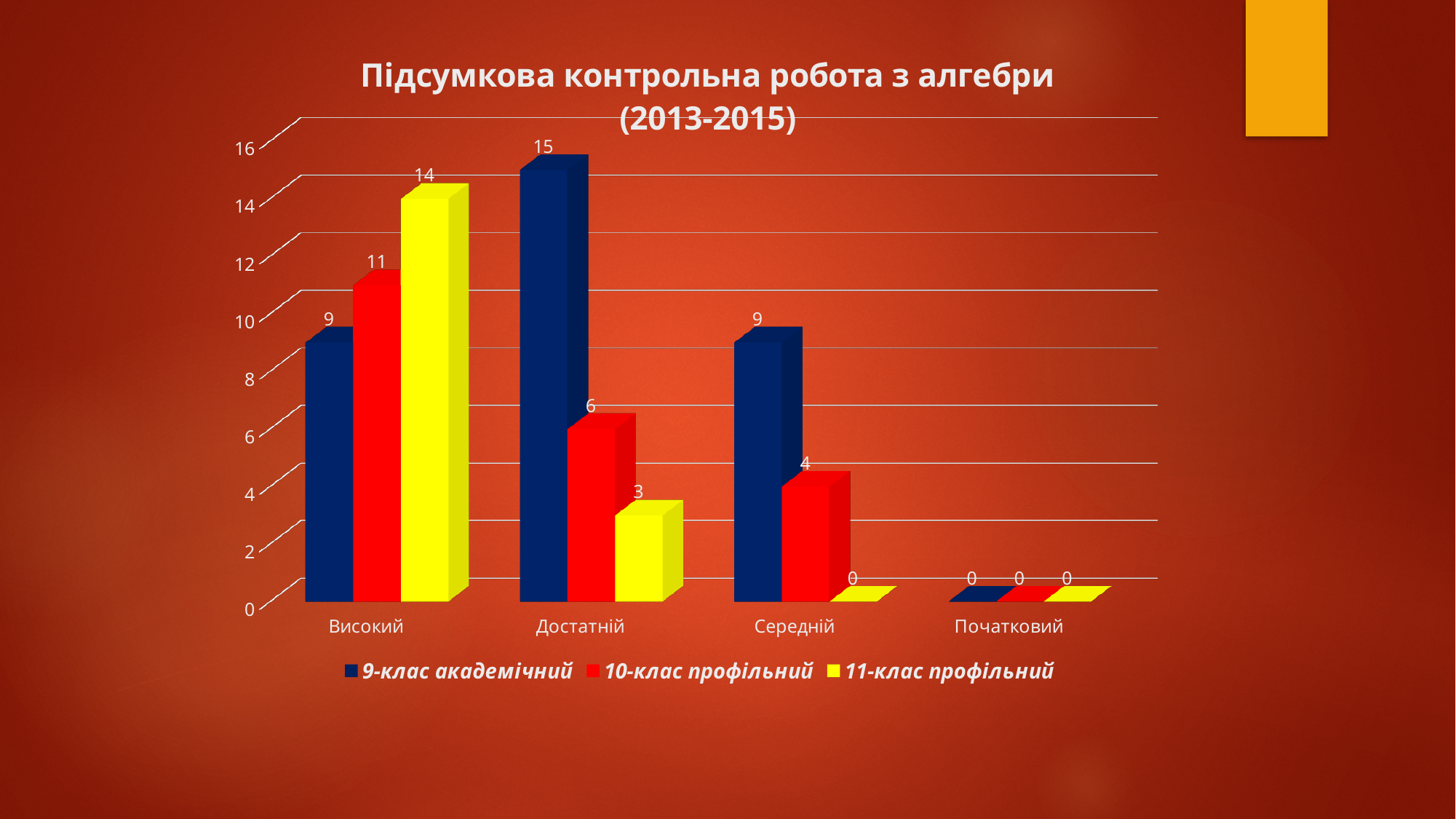
Which category has the lowest value for 10-клас профільний? Початковий What kind of chart is shown on the slide? bar chart What is the value for 9-клас академічний in the Високий category? 9 What is the value for 11-клас профільний in the Достатній category? 3 In the Достатній category, which series has the larger value: 9-клас академічний or 10-клас профільний? 9-клас академічний How many series does the legend list? 3 Which category has the highest value for 9-клас академічний? Достатній What is the title of the chart? Підсумкова контрольна робота з алгебри (2013-2015) What is the total of the three series values in the Середній category? 13 How many categories are shown on the x axis? 4 What is the value for 10-клас профільний in the Середній category? 4 What is the difference between the 11-клас профільний value and the 9-клас академічний value in the Високий category? 5